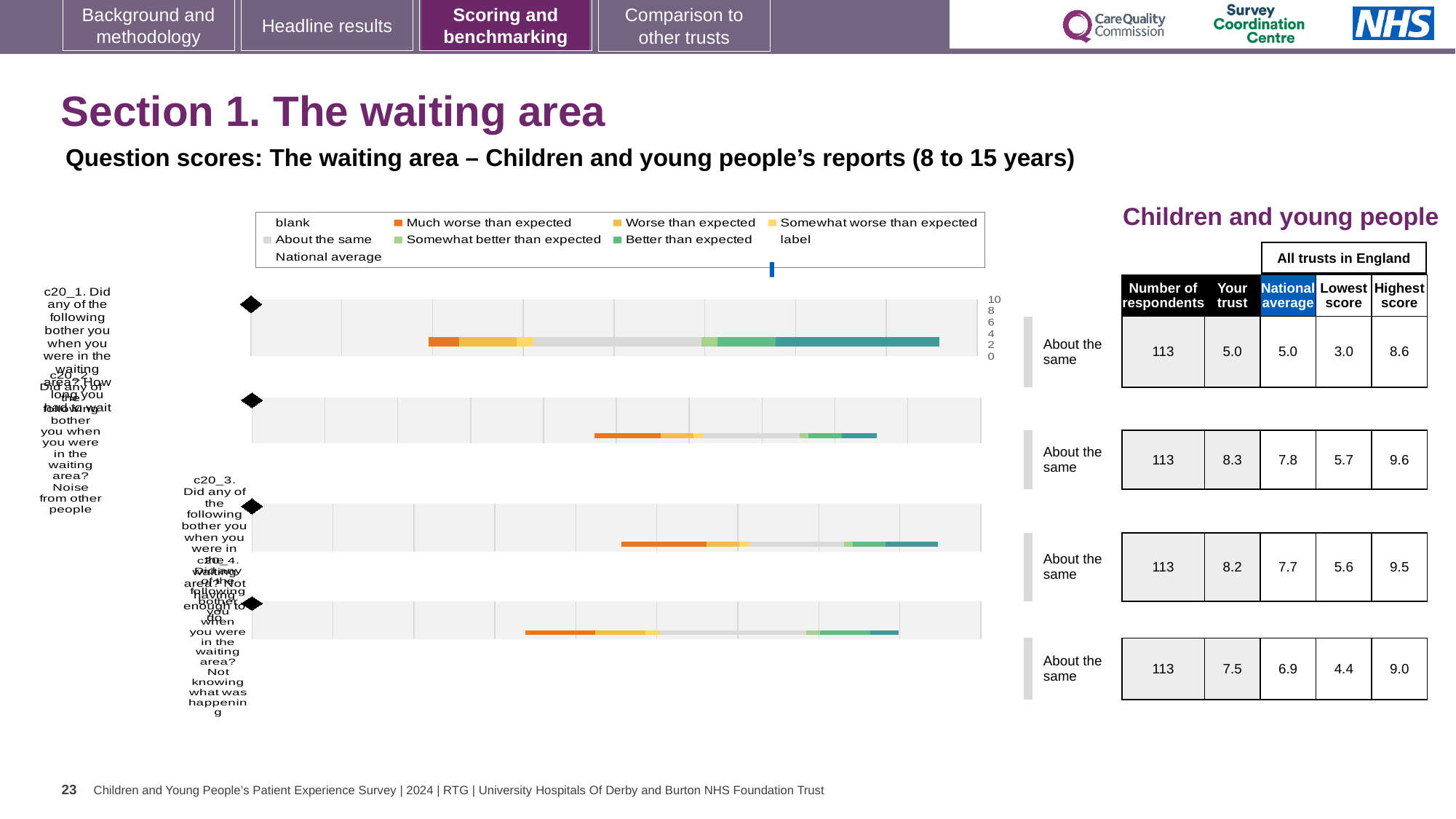
According to the table next to the charts, what is the national average for question c20_4? 6.9 What kind of chart is used to show the question scores on this slide? bar chart How many separate bar charts (one per question) are shown on the slide? 4 According to the table next to the charts, what is the highest score for question c20_3? 9.5 What benchmark category label is shown beside each of the four bar charts? About the same Which question has the lowest 'Your trust' score in the table next to the charts? c20_1 Which question has the highest 'Your trust' score in the table next to the charts? c20_2 What is the difference between the 'Your trust' score and the national average for question c20_2 in the table next to the charts? 0.5 What is the highest tick value shown on the axis of the top bar chart? 10 According to the table next to the charts, what is the 'Your trust' score for question c20_2? 8.3 According to the table next to the charts, what is the 'Your trust' score for question c20_1? 5.0 In the legend, which colour represents 'Much worse than expected'? orange